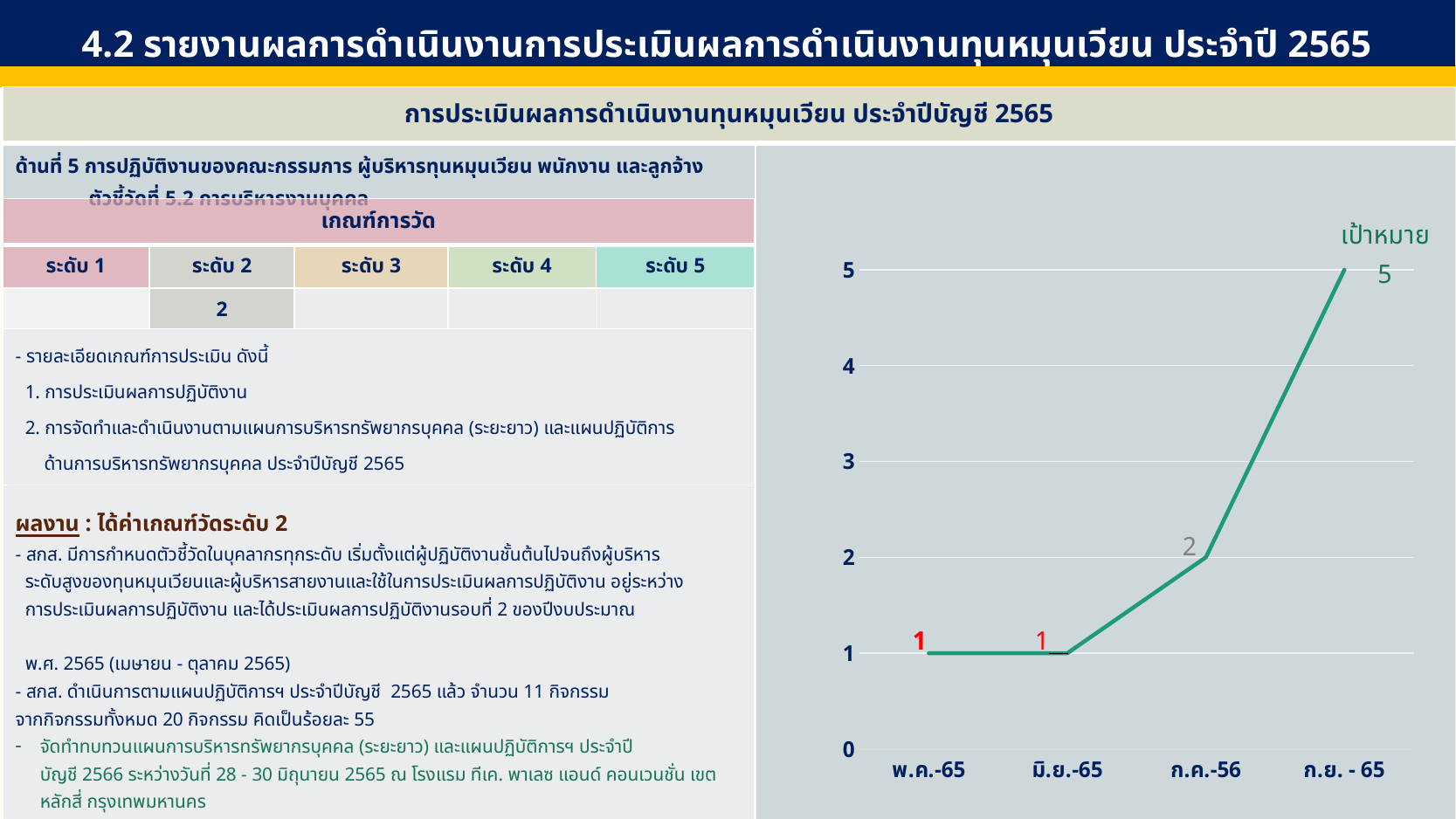
Which is larger in the line chart, the value for ก.ค.-56 or the value for มิ.ย.-65? ก.ค.-56 What is the value for มิ.ย.-65 in the line chart? 1 What is the value for พ.ค.-65 in the line chart? 1 What is the value for ก.ย. - 65 in the line chart? 5 What is the value for ก.ค.-56 in the line chart? 2 What is the difference between the values for ก.ค.-56 and พ.ค.-65 in the line chart? 1 What kind of chart is shown on the right side of the slide? line chart How many data points are plotted in the line chart? 4 What label is written next to the last point of the line chart? เป้าหมาย What is the difference between the values for ก.ย. - 65 and ก.ค.-56 in the line chart? 3 Do the values in the line chart rise or fall from left to right along the x axis? rise Which category has the highest value in the line chart? ก.ย. - 65